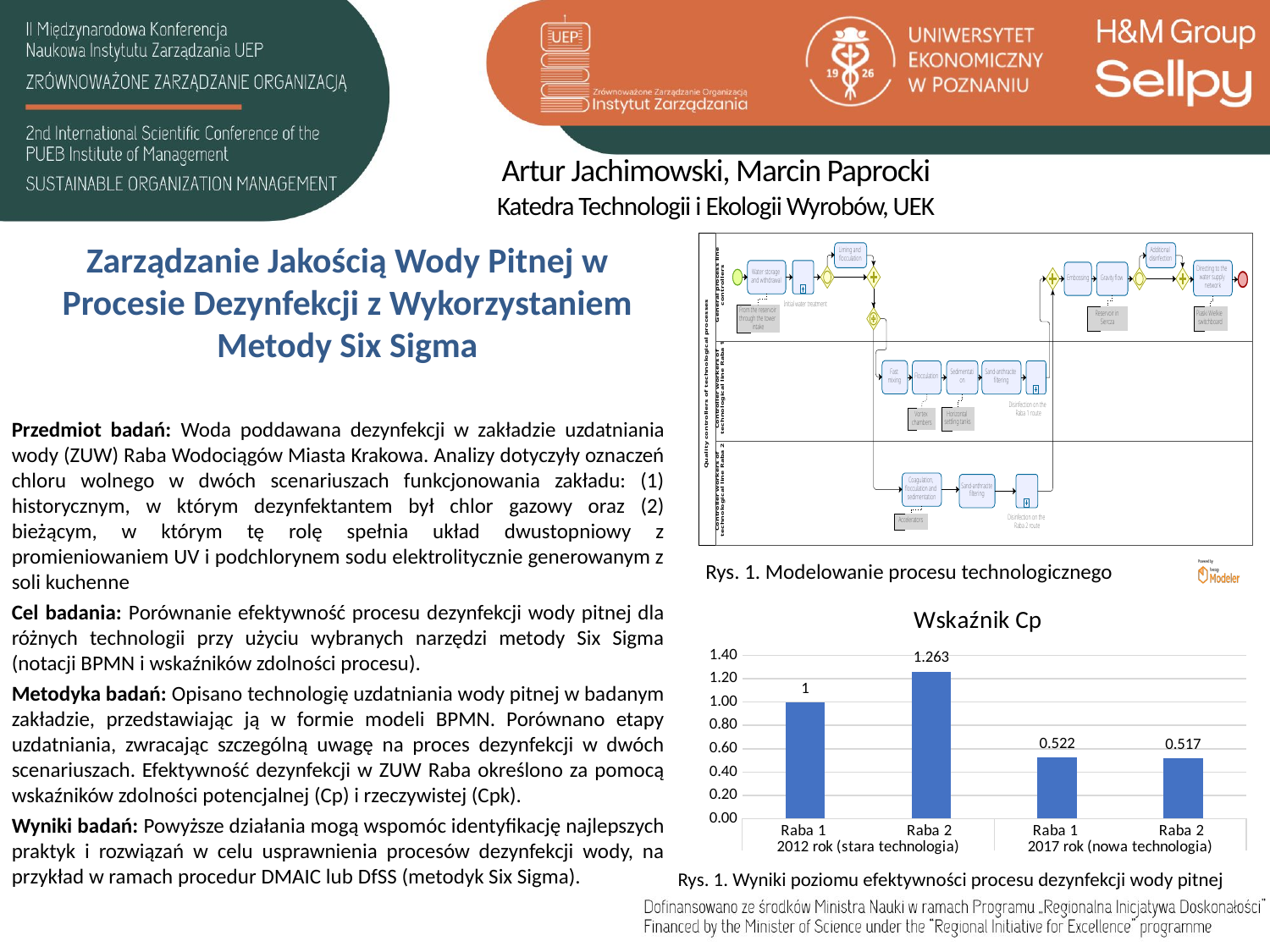
What is the difference between the Cp value of Raba 1 in 2012 and Raba 1 in 2017? 0.478 What is the title of the chart on the slide? Wskaźnik Cp What is the difference between the Cp values of Raba 2 and Raba 1 in 2012 rok (stara technologia)? 0.263 What is the Cp value for Raba 1 in 2012 rok (stara technologia)? 1 Which bar has the highest Cp value? Raba 2, 2012 rok (stara technologia) What is the Cp value for Raba 2 in 2017 rok (nowa technologia)? 0.517 Which is larger: the Cp value for Raba 1 in 2012 or for Raba 1 in 2017? Raba 1 in 2012 How many bars are plotted in the Wskaźnik Cp chart? 4 Is the Cp value for Raba 2 in 2017 rok (nowa technologia) greater or less than 0.60? less What is the Cp value for Raba 1 in 2017 rok (nowa technologia)? 0.522 What type of chart is the "Wskaźnik Cp" chart? bar chart What is the Cp value for Raba 2 in 2012 rok (stara technologia)? 1.263